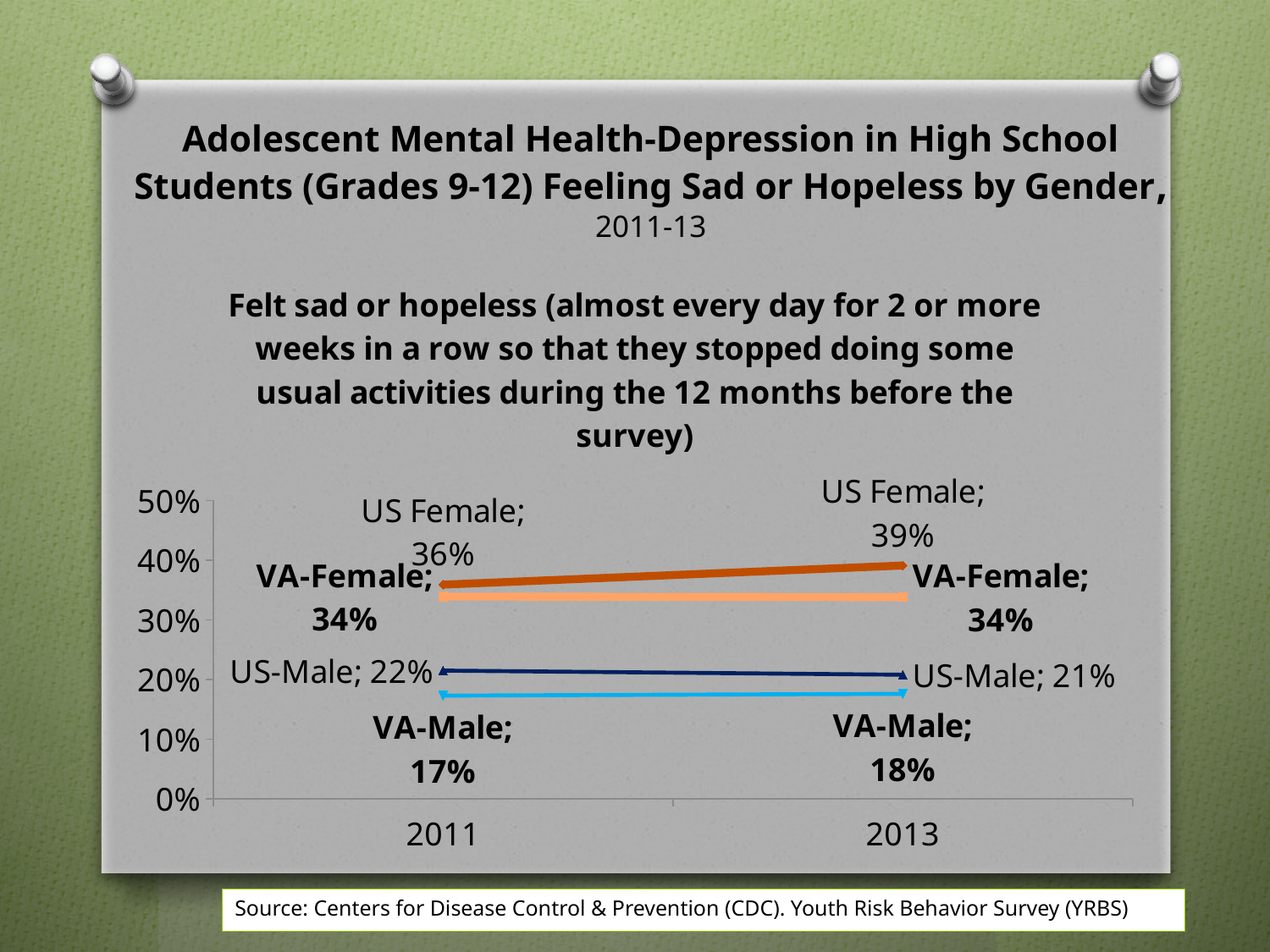
What was the value for US Female in 2013? 39% What was the value for VA-Female in 2011? 34% Which is larger in 2011: the US-Male value or the VA-Male value? US-Male What is the difference between the US Female value in 2013 and the US Female value in 2011? 3% What was the value for US-Male in 2013? 21% Did the US-Male value rise or fall from 2011 to 2013? Fall Which series had the highest value in 2013? US Female How many series (lines) are plotted on the chart? 4 How many years are shown on the x axis? 2 Which series had the lowest value in 2011? VA-Male What was the value for VA-Male in 2011? 17% What type of chart is shown on the slide? Line chart